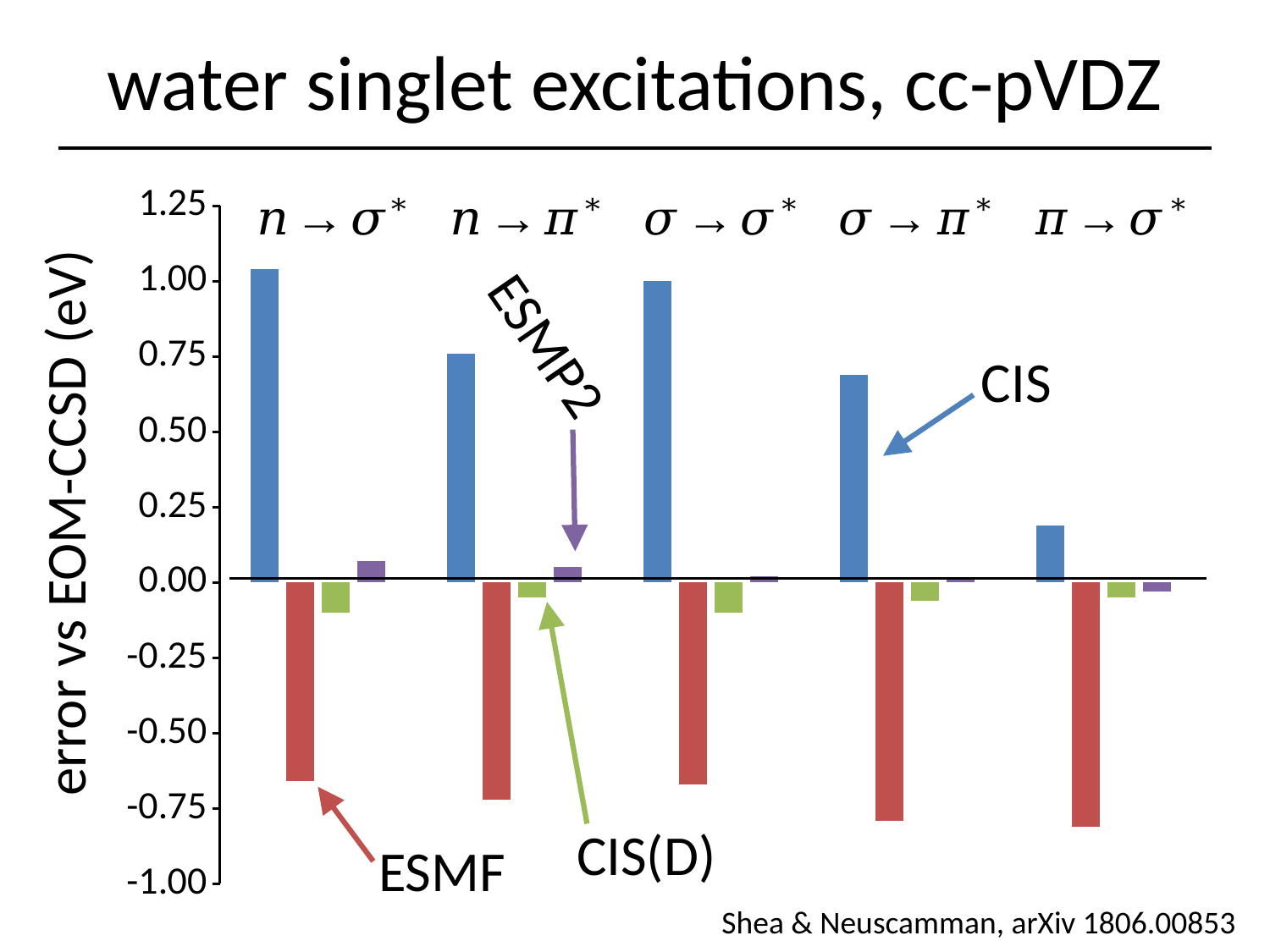
Is the ESMF error for π → σ* greater or less than -0.75? less Is the CIS error for n → σ* greater or less than 1.00? greater Which is larger, the CIS error for n → π* or the CIS error for σ → π*? n → π* What kind of chart is shown on the slide? bar chart Is the CIS error for σ → π* greater or less than 0.50? greater Which method is shown with blue bars? CIS For which excitation is the CIS error smallest? π → σ* What is the y-axis label of the chart? error vs EOM-CCSD (eV) How many methods (series) are labelled on the chart? 4 How many excitation categories are shown along the x axis? 5